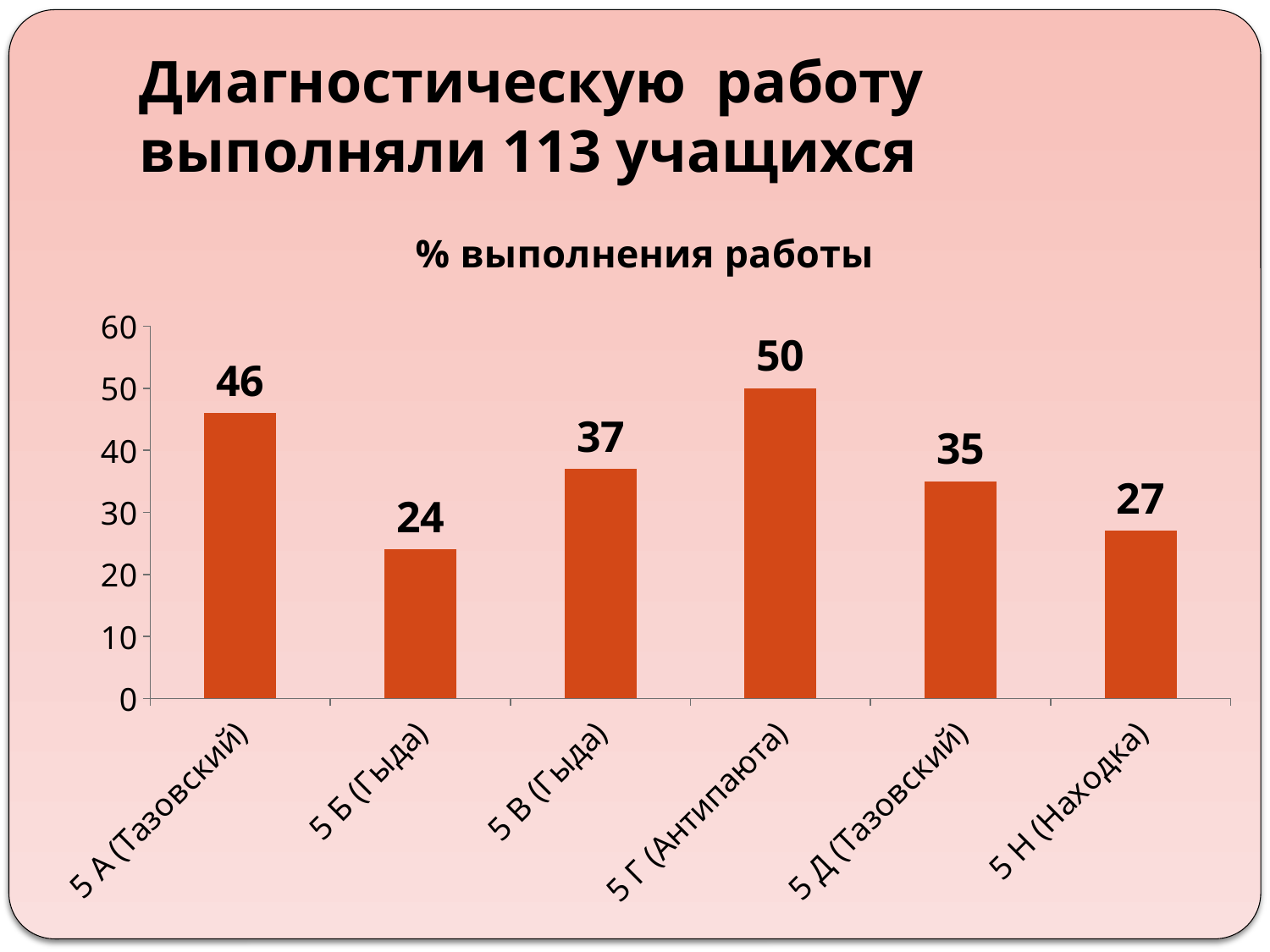
What is the value for 5 Г (Антипаюта)? 50 What is the value for 5 А (Тазовский)? 46 Which is larger, the value for 5 В (Гыда) or the value for 5 Н (Находка)? 5 В (Гыда) Which category has the highest value? 5 Г (Антипаюта) What is the value for 5 Н (Находка)? 27 What is the difference between the values for 5 А (Тазовский) and 5 Д (Тазовский)? 11 What kind of chart is shown on the slide? bar chart What is the value for 5 Б (Гыда)? 24 How many categories are shown on the chart? 6 Which category has the lowest value? 5 Б (Гыда) What is the title of the chart? % выполнения работы What is the difference between the values for 5 Г (Антипаюта) and 5 Б (Гыда)? 26